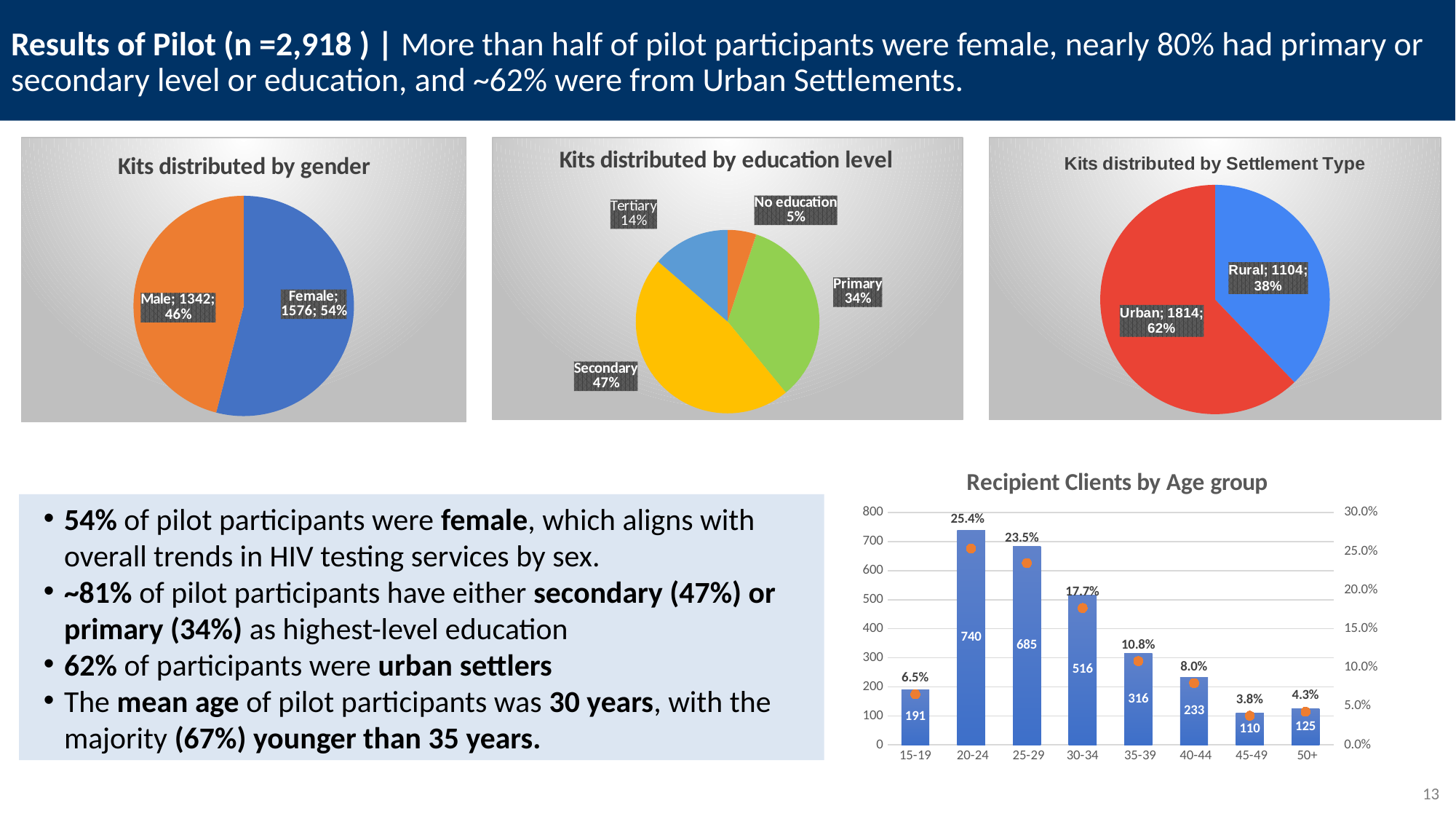
In the 'Kits distributed by Settlement Type' pie chart, how many more kits went to Urban than to Rural settlements? 710 In the 'Kits distributed by education level' pie chart, which education level has the largest share? Secondary How many education levels are shown in the 'Kits distributed by education level' pie chart? 4 In the 'Kits distributed by education level' pie chart, which education level has the smallest share? No education In the 'Recipient Clients by Age group' chart, which age group has the highest number of recipient clients? 20-24 In the 'Kits distributed by gender' pie chart, what share of kits went to males? 46% In the 'Recipient Clients by Age group' chart, what percentage is shown for the 30-34 age group? 17.7% In the 'Recipient Clients by Age group' chart, how many recipient clients are in the 35-39 age group? 316 In the 'Recipient Clients by Age group' chart, which has more recipient clients: the 45-49 group or the 50+ group? 50+ How many age groups are shown in the 'Recipient Clients by Age group' chart? 8 In the 'Kits distributed by Settlement Type' pie chart, how many kits were distributed in urban settlements? 1814 In the 'Kits distributed by gender' pie chart, how many kits were distributed to females? 1576